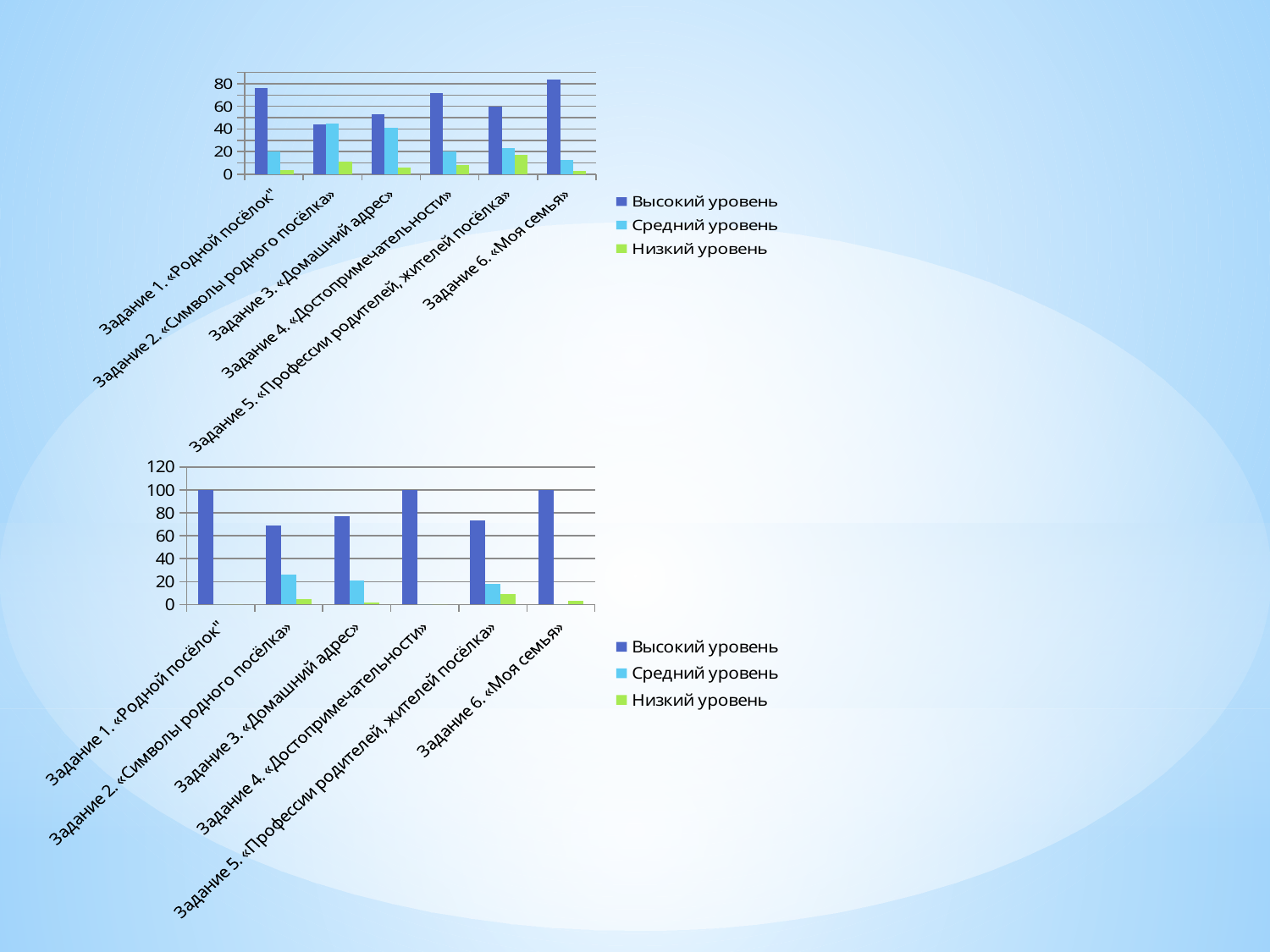
In the bottom chart, which task has the highest value for Низкий уровень? Задание 5. «Профессии родителей, жителей посёлка» In the top chart, which task has the lowest value for Высокий уровень? Задание 2. «Символы родного посёлка» In the top chart, which task has the highest value for Высокий уровень? Задание 6. «Моя семья» In the bottom chart, is the Высокий уровень value for Задание 2. «Символы родного посёлка» greater or less than 80? less In the bottom chart, what is the Высокий уровень value for Задание 1. «Родной посёлок»? 100 In the top chart, which is larger: the Низкий уровень value for Задание 5 or for Задание 1? Задание 5 What are the three legend entries of the bottom chart? Высокий уровень, Средний уровень, Низкий уровень What kind of chart is the top chart on the slide? bar chart How many series does the legend of the top chart list? 3 In the top chart, is the Средний уровень value for Задание 6. «Моя семья» greater or less than 20? less How many categories (tasks) are shown on the x axis of the bottom chart? 6 In the top chart, is the Высокий уровень value for Задание 1. «Родной посёлок» greater or less than 60? greater